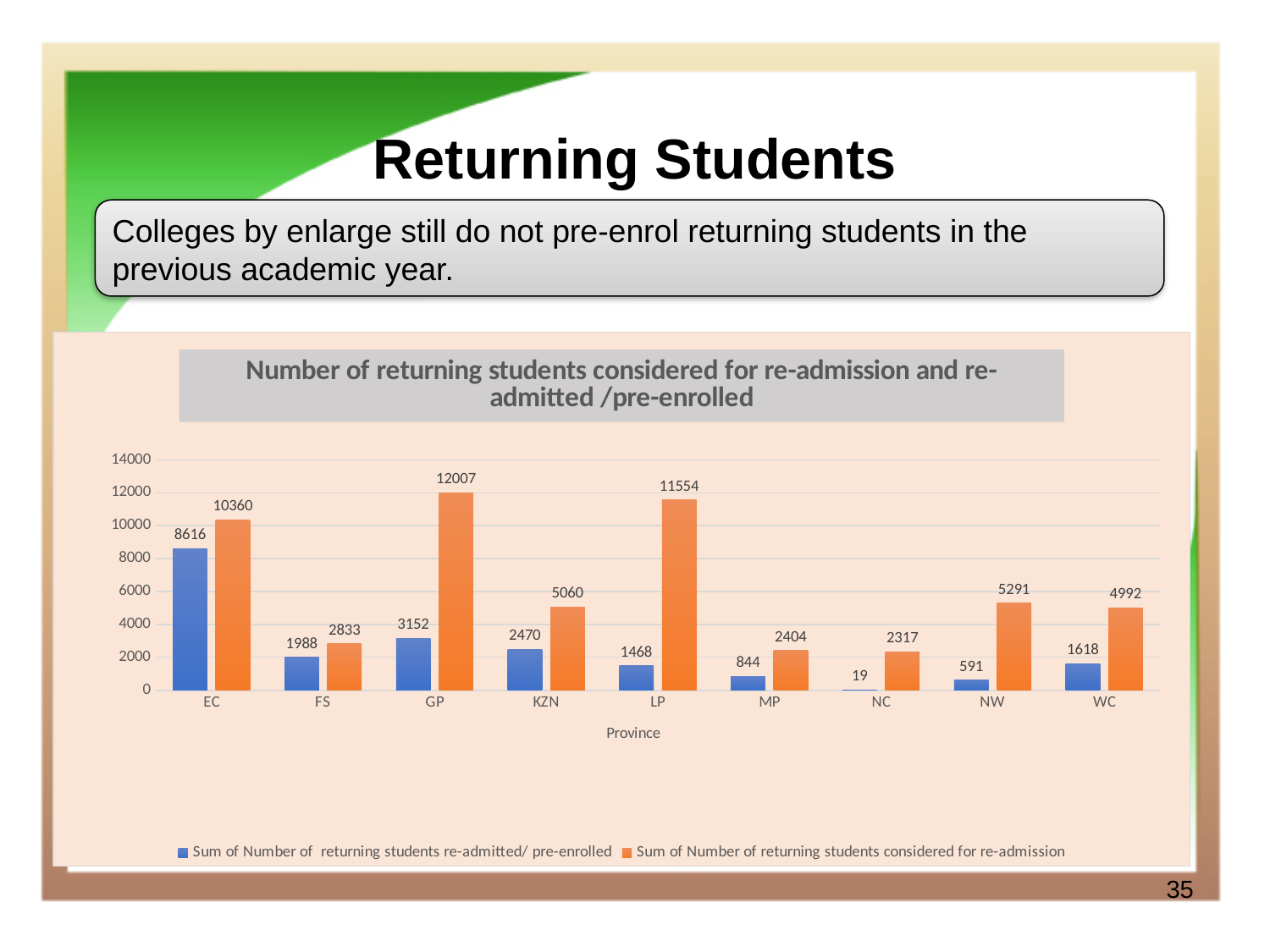
Which is larger: the number of returning students considered for re-admission in NW or in WC? NW What colour are the bars for the 'Sum of Number of returning students considered for re-admission' series? orange What is the number of returning students considered for re-admission in GP? 12007 How many provinces are shown on the x axis of the chart? 9 What is the number of returning students re-admitted/pre-enrolled in NC? 19 How many series does the chart's legend list? 2 Is the number of returning students considered for re-admission in KZN greater or less than 4000? greater What type of chart is shown on the slide? bar chart Which province has the lowest number of returning students considered for re-admission? NC What is the difference between the number of returning students considered for re-admission and the number re-admitted/pre-enrolled in LP? 10086 Which province has the highest number of returning students re-admitted/pre-enrolled? EC What is the difference between the number of returning students considered for re-admission in EC and the number re-admitted/pre-enrolled in EC? 1744